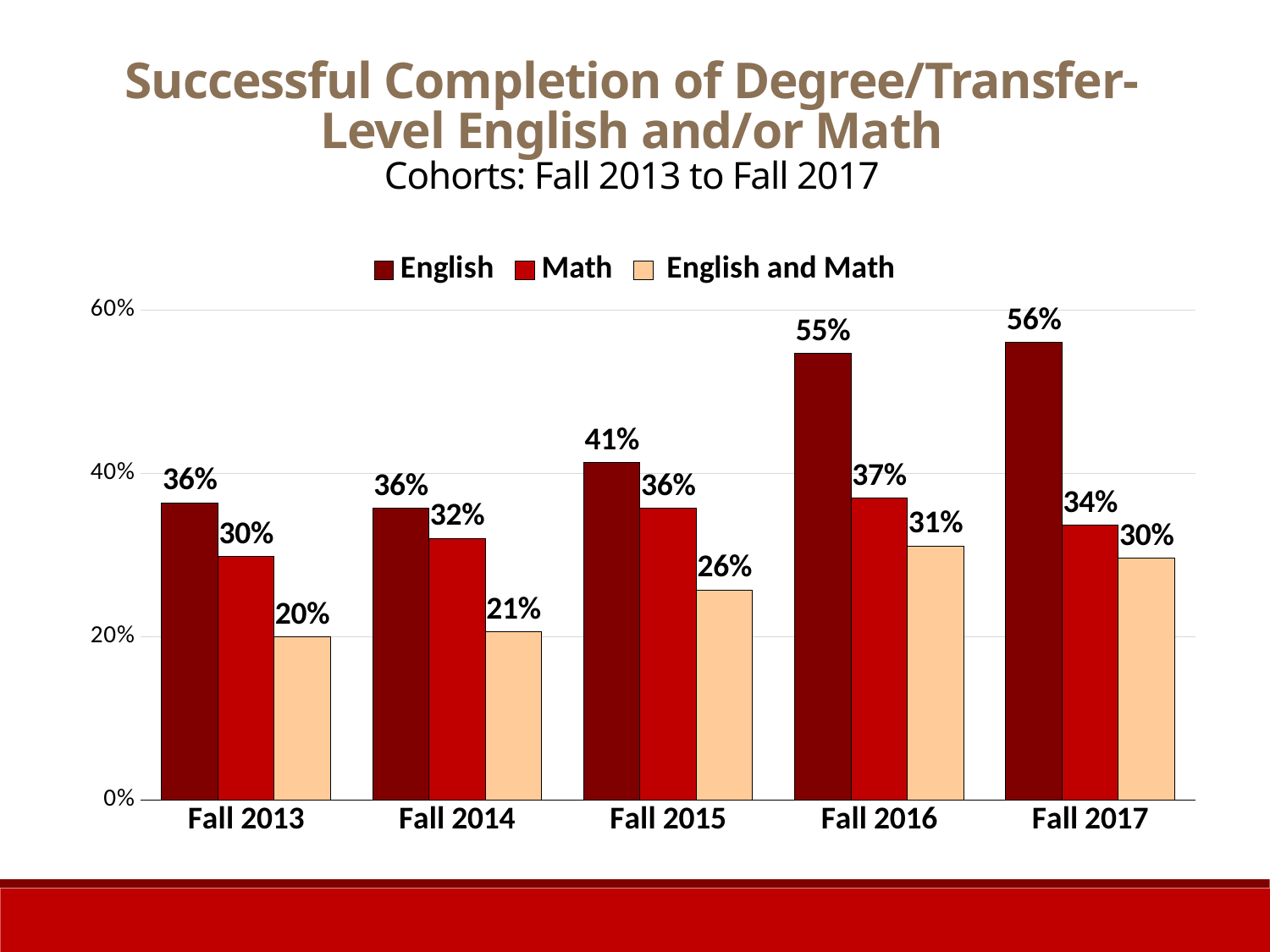
Does the English completion rate rise or fall from Fall 2014 to Fall 2017? Rise Which is larger for the Fall 2016 cohort: the Math rate or the English and Math rate? Math What is the difference between the English rate and the Math rate for the Fall 2017 cohort? 22% Which cohort has the highest English completion rate? Fall 2017 What is the English and Math completion rate for the Fall 2015 cohort? 26% What is the Math completion rate for the Fall 2014 cohort? 32% Which cohort has the lowest English and Math completion rate? Fall 2013 What kind of chart is shown on the slide? Bar chart What is the subtitle shown below the chart title? Cohorts: Fall 2013 to Fall 2017 How many cohorts are shown on the x axis? 5 What is the English completion rate for the Fall 2016 cohort? 55% How many series does the legend list? 3